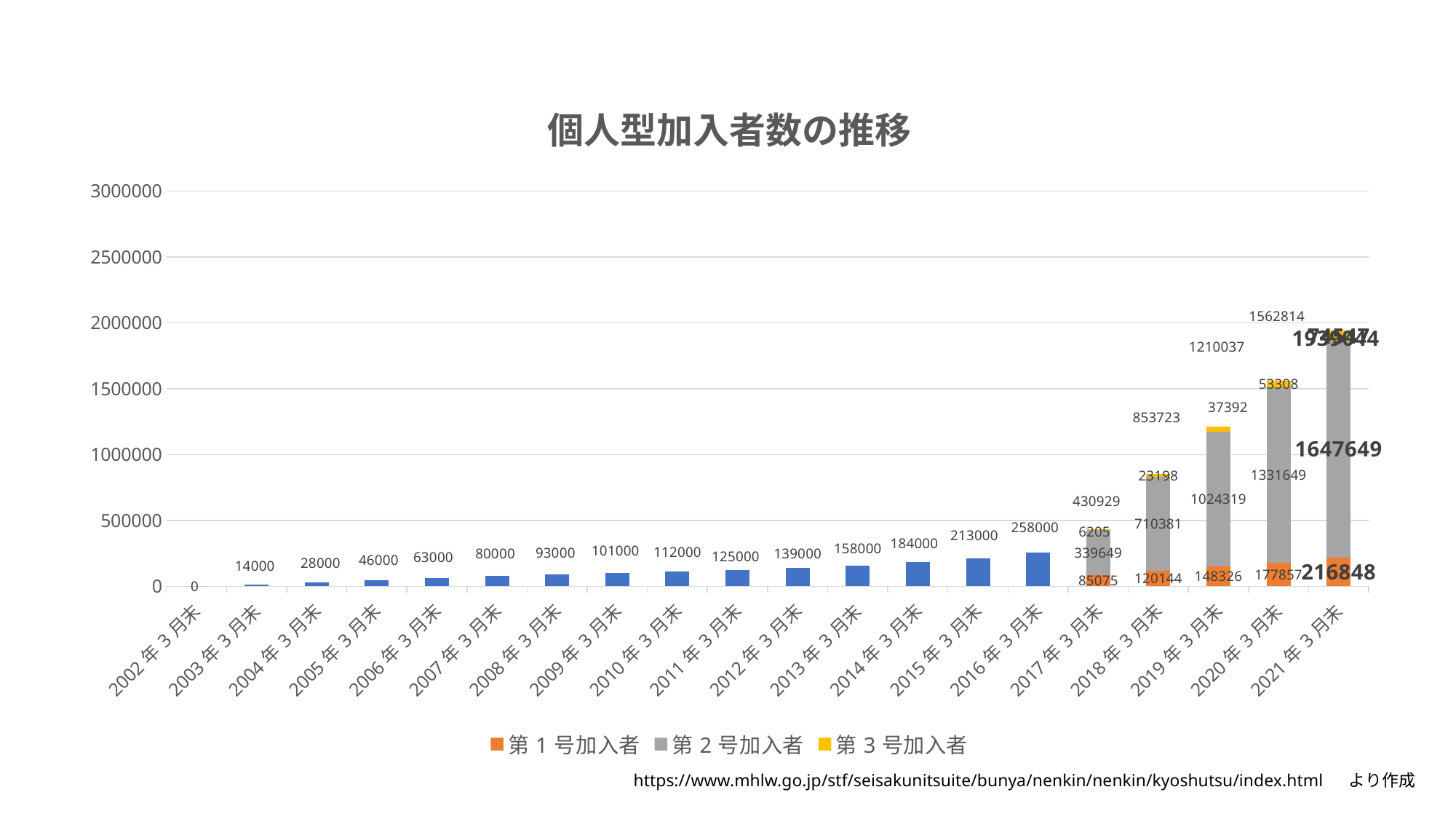
What is the difference between the values for 2016年3月末 and 2015年3月末? 45000 How many categories are shown on the x axis? 20 What is the title of the chart? 個人型加入者数の推移 Do the values generally rise or fall from 2002年3月末 to 2021年3月末? rise What is the total of the stacked bar for 2018年3月末? 853723 What is the value shown for 2016年3月末? 258000 How many series does the legend list? 3 What is the value of 第2号加入者 for 2019年3月末? 1024319 What type of chart is shown on the slide? bar chart What is the value of 第3号加入者 for 2018年3月末? 23198 Which category has the highest bar? 2021年3月末 What is the value of 第1号加入者 for 2021年3月末? 216848